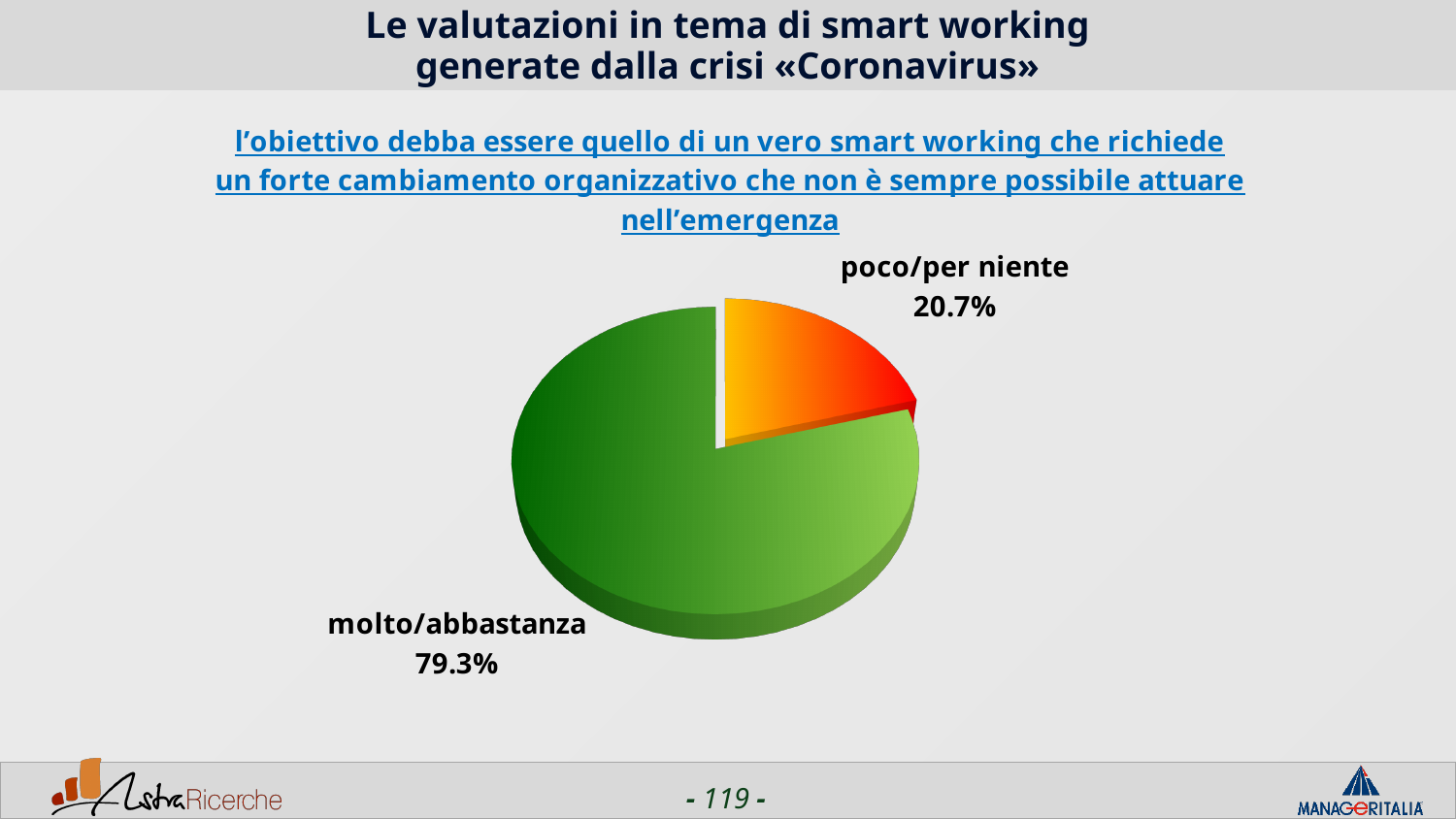
What percentage is shown for the 'poco/per niente' slice? 20.7% What share of the pie does the 'poco/per niente' slice represent? 20.7% Which slice of the pie is the smallest? poco/per niente What percentage is shown for the 'molto/abbastanza' slice? 79.3% Which slice of the pie is the largest? molto/abbastanza What colour is the 'poco/per niente' slice? orange/red What is the difference in percentage points between the 'molto/abbastanza' and 'poco/per niente' slices? 58.6 How many slices does the pie chart have? 2 Which is larger, the 'molto/abbastanza' slice or the 'poco/per niente' slice? molto/abbastanza What kind of chart is shown on the slide? pie chart What colour is the 'molto/abbastanza' slice? green